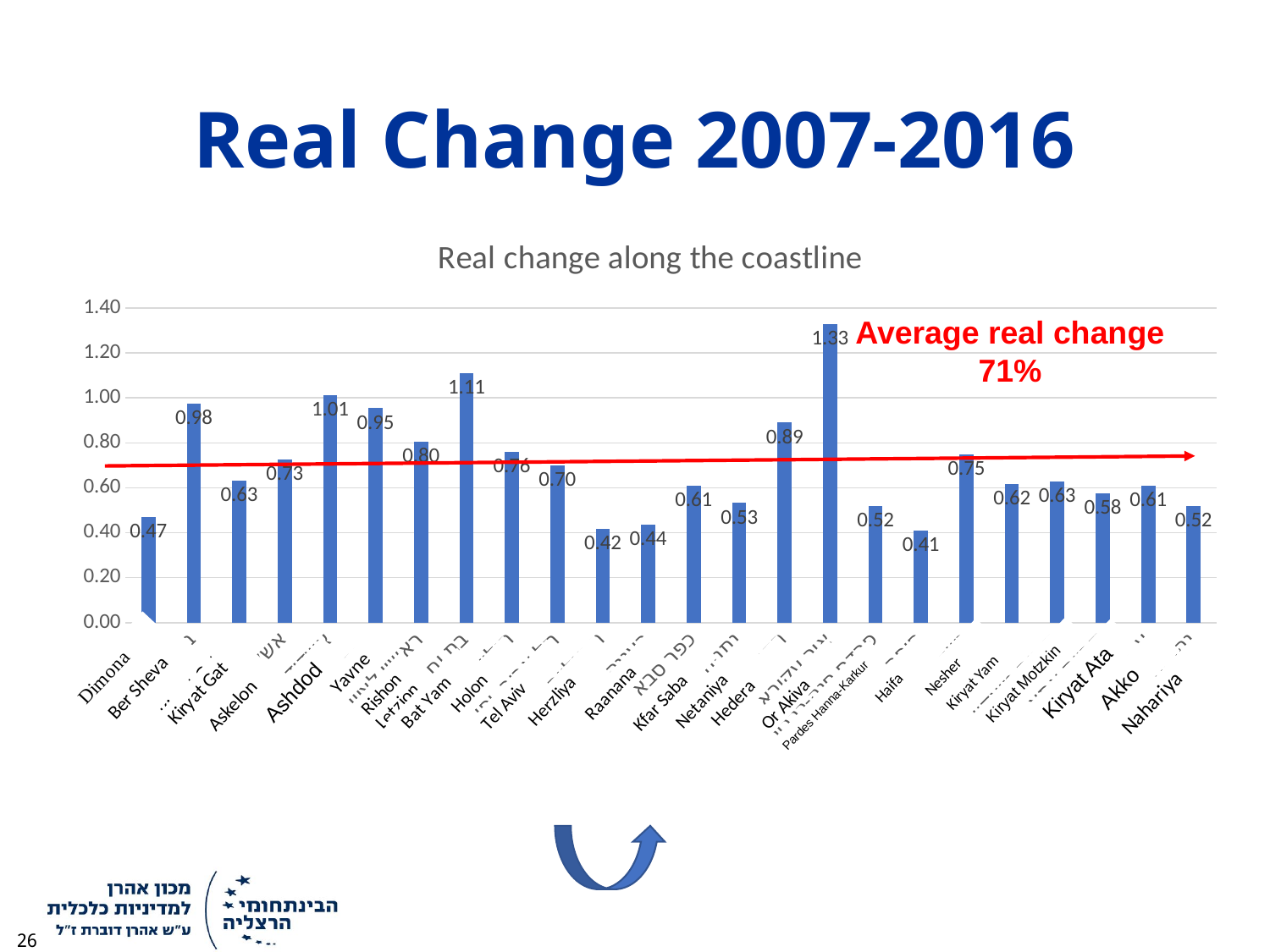
How many cities are shown in the chart? 24 Which city has the highest real change in the chart? Or Akiva What is the value for Bat Yam? 1.11 What kind of chart is shown on the slide? Bar chart What is the value for Or Akiva in the chart? 1.33 What average real change is annotated on the chart? 71% What is the difference between the values for Or Akiva and Bat Yam? 0.22 Which has a larger value, Hedera or Tel Aviv? Hedera What is the value for Haifa? 0.41 What is the difference between the values for Ashdod and Dimona? 0.54 What is the value for Dimona? 0.47 Which city has the lowest real change in the chart? Haifa